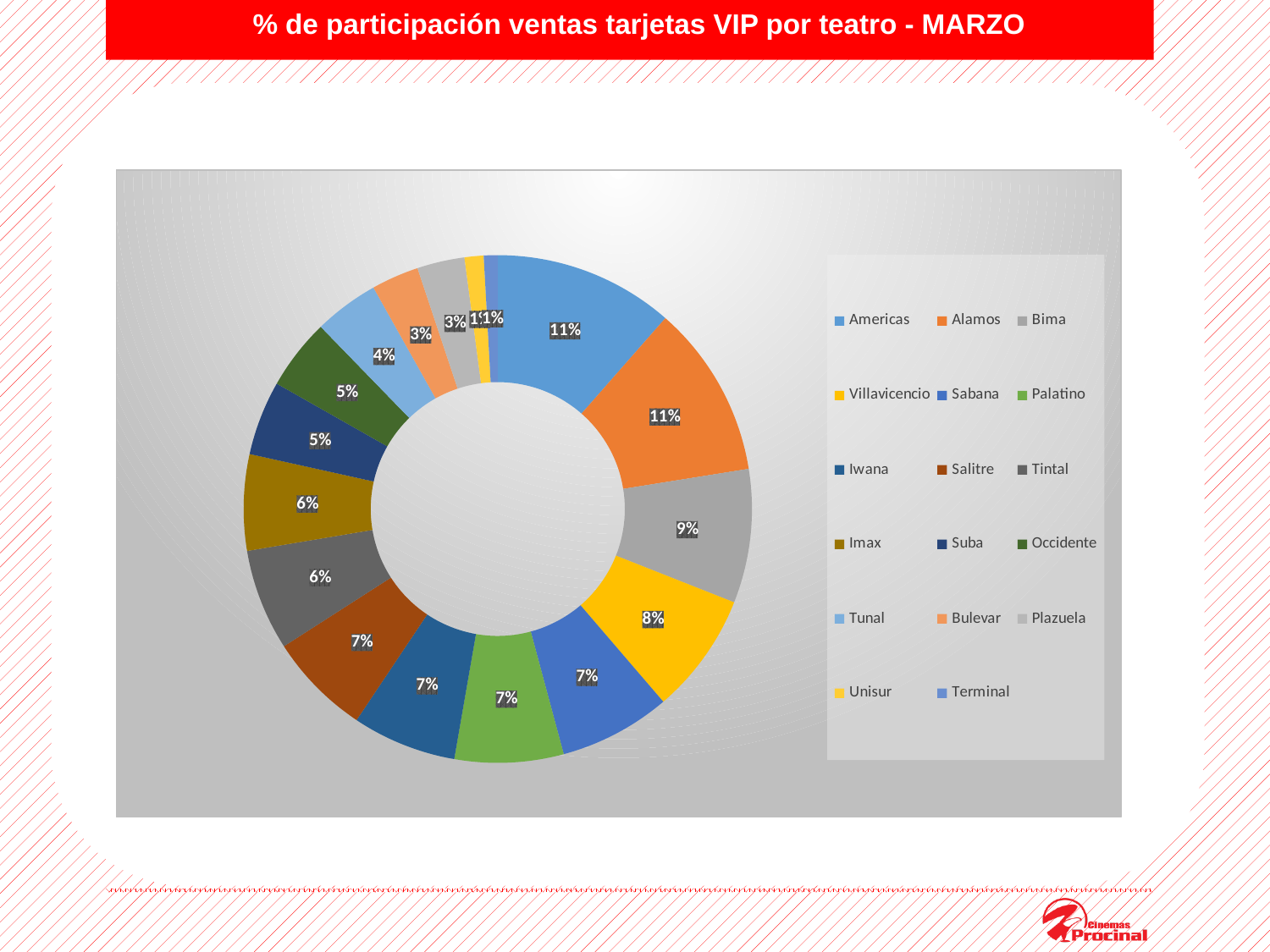
What is the share for Villavicencio? 8% What is the difference between the shares of Alamos and Occidente? 6% What is the share for Imax? 6% How many theatres (categories) are listed in the legend? 17 What is the share for Bima? 9% What kind of chart is shown on the slide? Doughnut (pie) chart What is the share for Tunal? 4% What is the share for Americas? 11% Which has a larger share, Suba or Tunal? Suba What is the title of the chart on the slide? % de participación ventas tarjetas VIP por teatro - MARZO What is the share for Bulevar? 3% Which has a larger share, Bima or Villavicencio? Bima